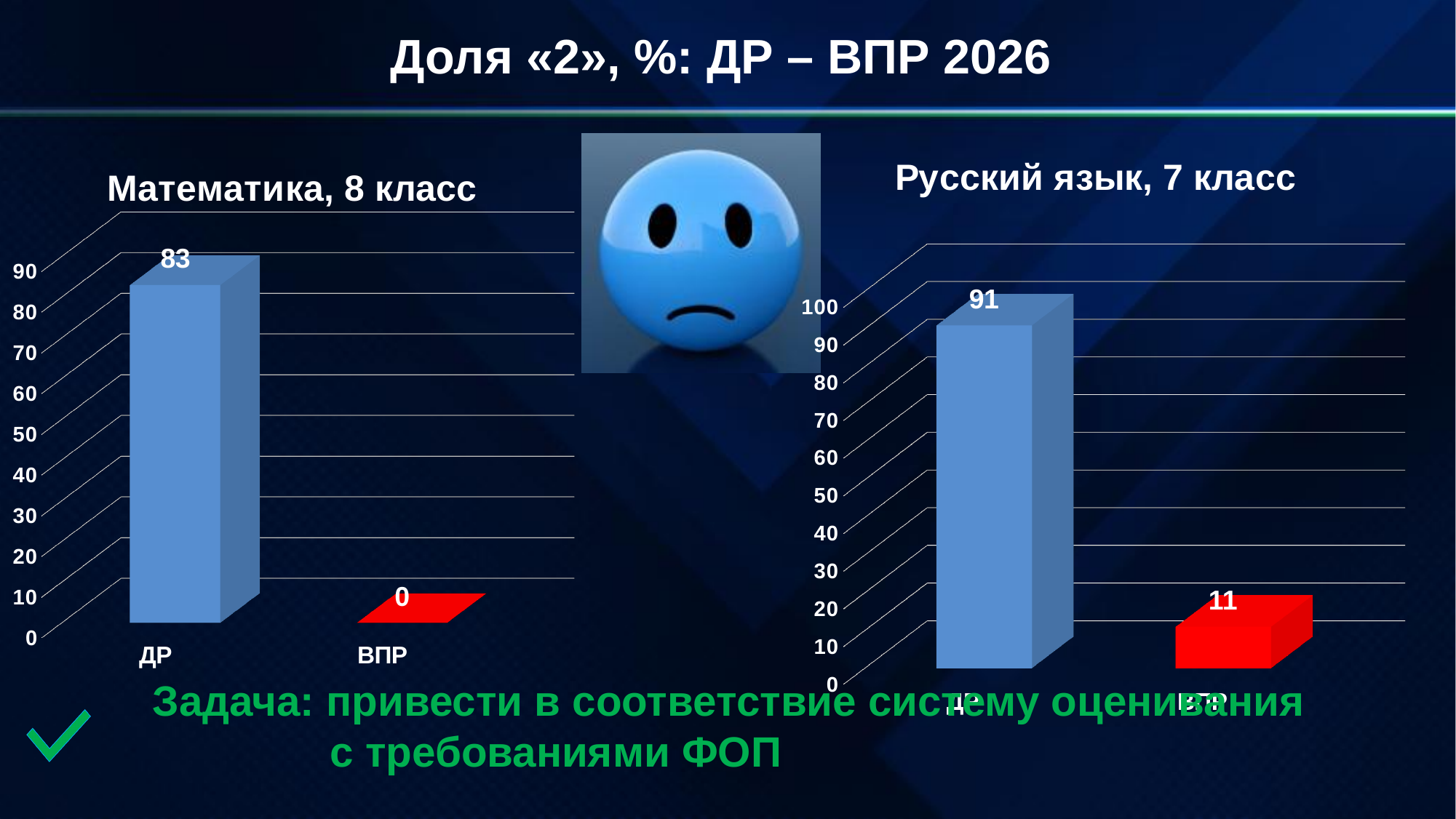
How many categories are shown in the chart titled "Математика, 8 класс"? 2 What type of chart is the chart titled "Русский язык, 7 класс"? bar chart In the chart titled "Русский язык, 7 класс", which category has the lowest value? ВПР In the chart titled "Русский язык, 7 класс", what is the difference between the ДР and ВПР values? 80 In the chart titled "Математика, 8 класс", what is the value for ВПР? 0 In the chart titled "Русский язык, 7 класс", what is the value for ДР? 91 In the chart titled "Математика, 8 класс", which category has the highest value? ДР In the chart titled "Математика, 8 класс", what is the value for ДР? 83 Which is larger: the ДР value in the "Математика, 8 класс" chart or the ДР value in the "Русский язык, 7 класс" chart? Русский язык, 7 класс In the chart titled "Математика, 8 класс", what is the difference between the ДР and ВПР values? 83 In the chart titled "Русский язык, 7 класс", is the value for ДР greater or less than 80? greater In the chart titled "Русский язык, 7 класс", what is the value for ВПР? 11